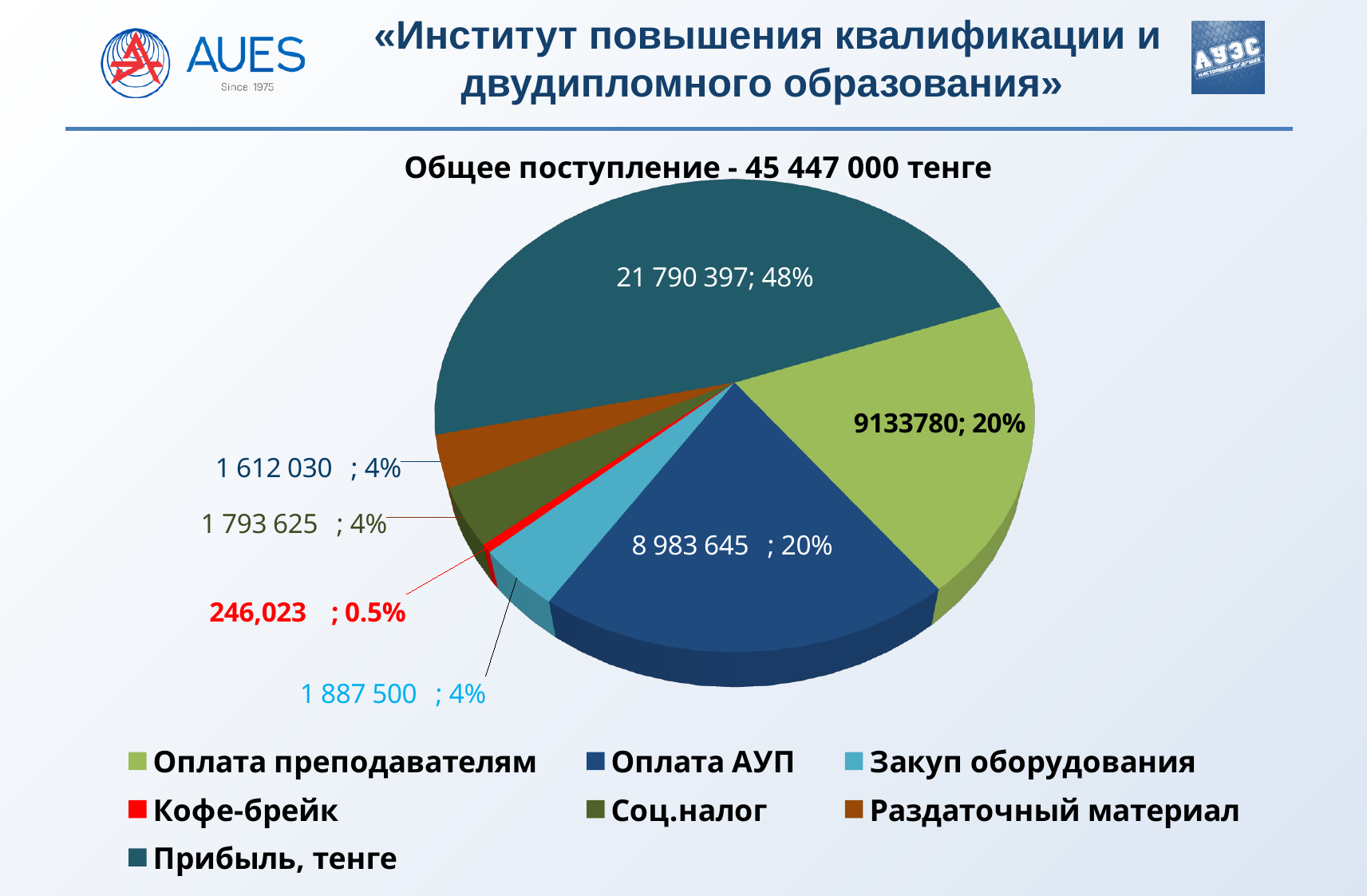
What value is shown for Оплата преподавателям? 9133780 What value is shown for Закуп оборудования? 1 887 500 What value is shown for Прибыль, тенге? 21 790 397 What share of the pie does Прибыль, тенге take? 48% What value is shown for Оплата АУП? 8 983 645 What is the title of the chart? Общее поступление - 45 447 000 тенге Which category has the smallest slice of the pie? Кофе-брейк Which category has the largest slice of the pie? Прибыль, тенге How many categories does the legend of the pie chart list? 7 What kind of chart is shown on the slide? pie chart What share of the pie does Кофе-брейк take? 0.5% Which is larger, the value for Оплата преподавателям or the value for Оплата АУП? Оплата преподавателям